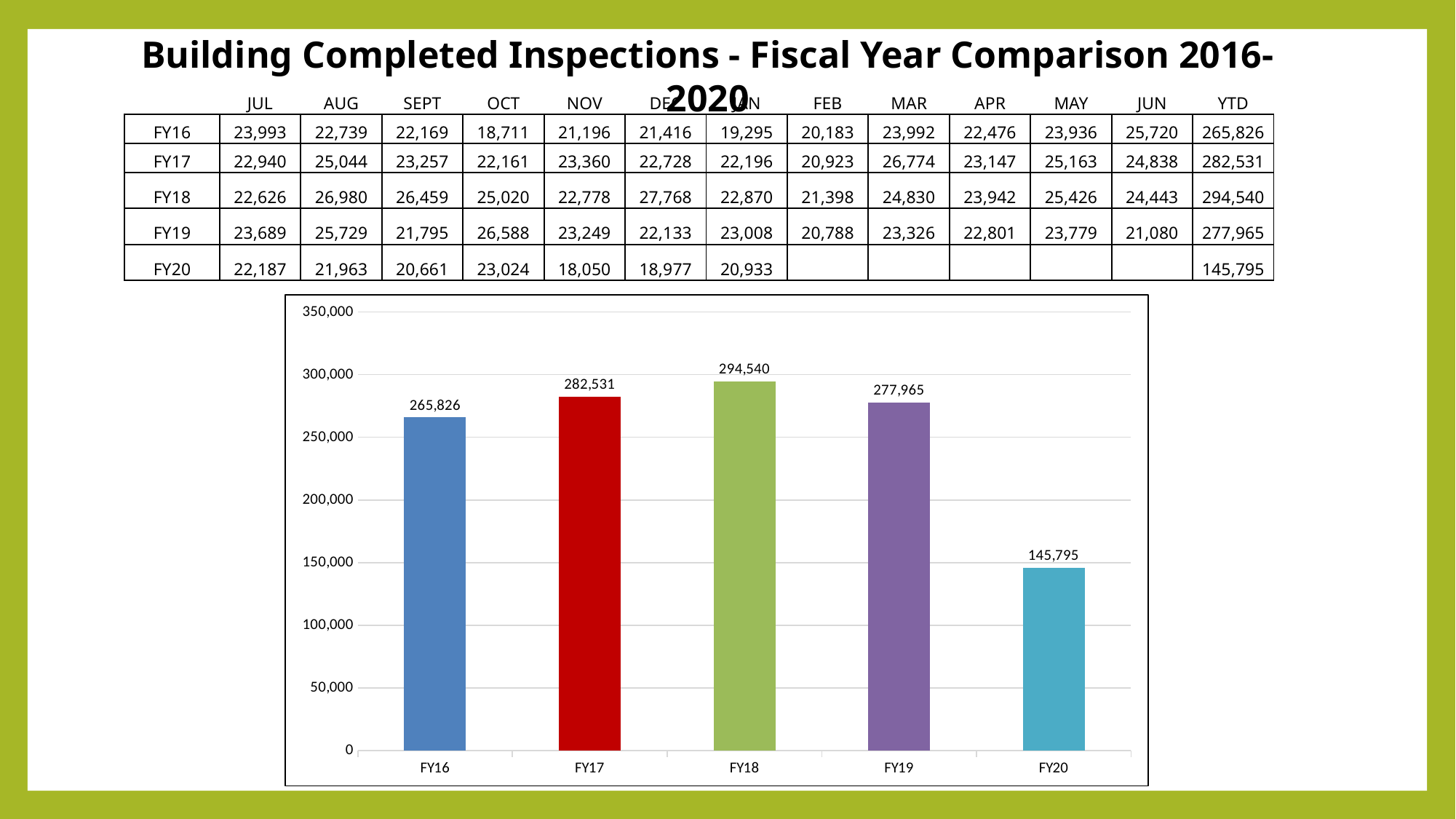
What is the difference between the FY19 and FY20 values in the bar chart? 132,170 What is the difference between the FY18 and FY17 values in the bar chart? 12,009 What is the value shown for FY16 in the bar chart? 265,826 What kind of chart is shown on the slide? Bar chart Which fiscal year has the lowest bar in the chart? FY20 Which fiscal year has the highest bar in the chart? FY18 Which is larger in the bar chart, the value for FY17 or the value for FY19? FY17 What colour is the FY17 bar in the chart? Red How many fiscal years are plotted as bars in the chart? 5 Is the value for FY16 in the bar chart greater or less than 250,000? greater What is the value shown for FY18 in the bar chart? 294,540 What is the value shown for FY20 in the bar chart? 145,795